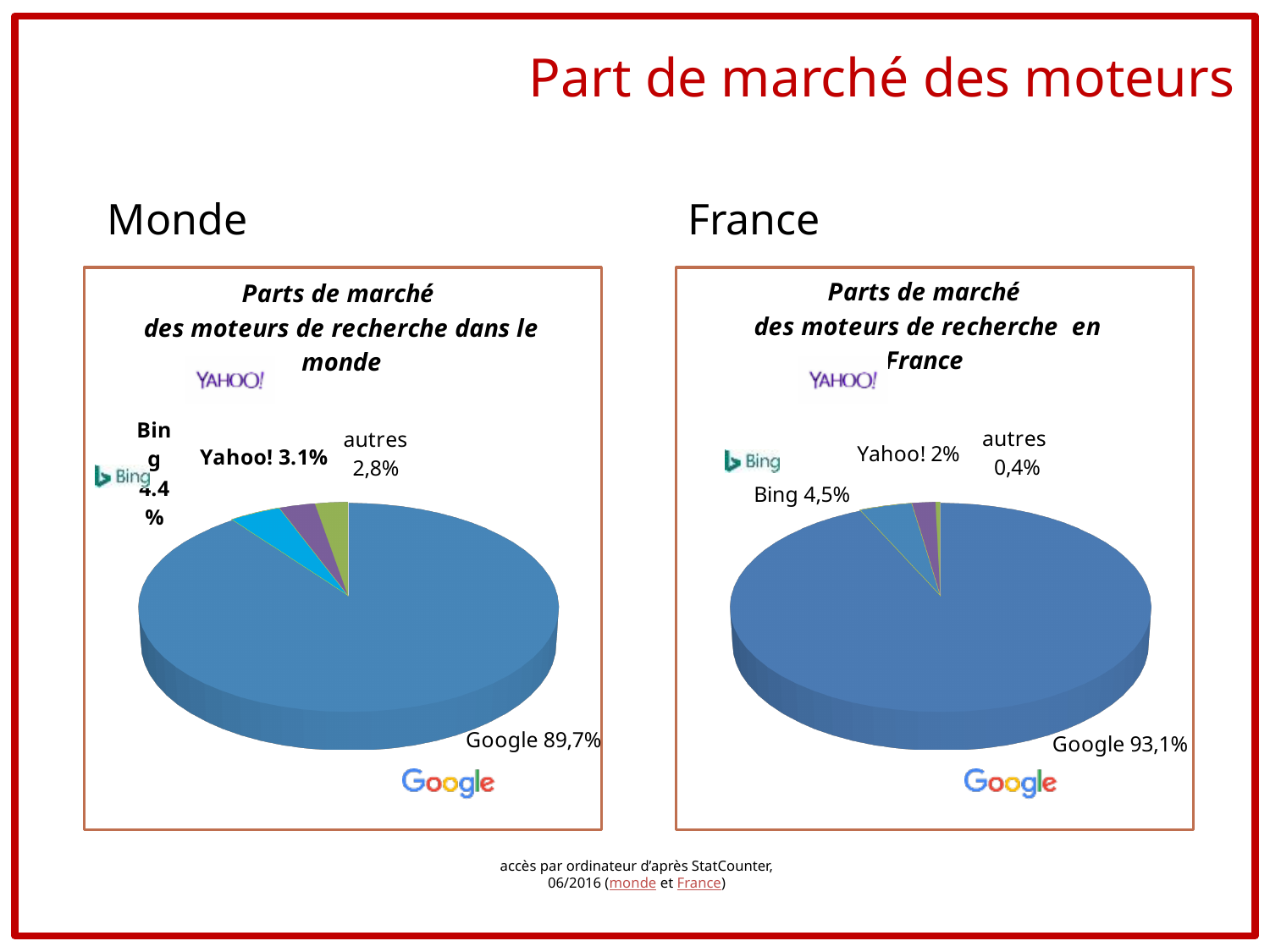
In the right chart (France), which is larger: Bing or Yahoo!? Bing In the right chart (France), what is Google's market share? 93,1% In the left chart (Monde), which search engine has the largest share? Google In the right chart (France), what is the share for Bing? 4,5% In the left chart (Monde), what is the share for Yahoo!? 3.1% Which is larger: Google's share in the Monde chart or Google's share in the France chart? France (93,1%) In the left chart (Monde), what is the share for Bing? 4.4% In the right chart (France), which category has the smallest share? autres How many slices does the left chart (Monde) have? 4 What type of chart is used on this slide? Pie chart In the left chart (Monde), what is Google's market share? 89,7% In the right chart (France), what is the share for 'autres'? 0,4%